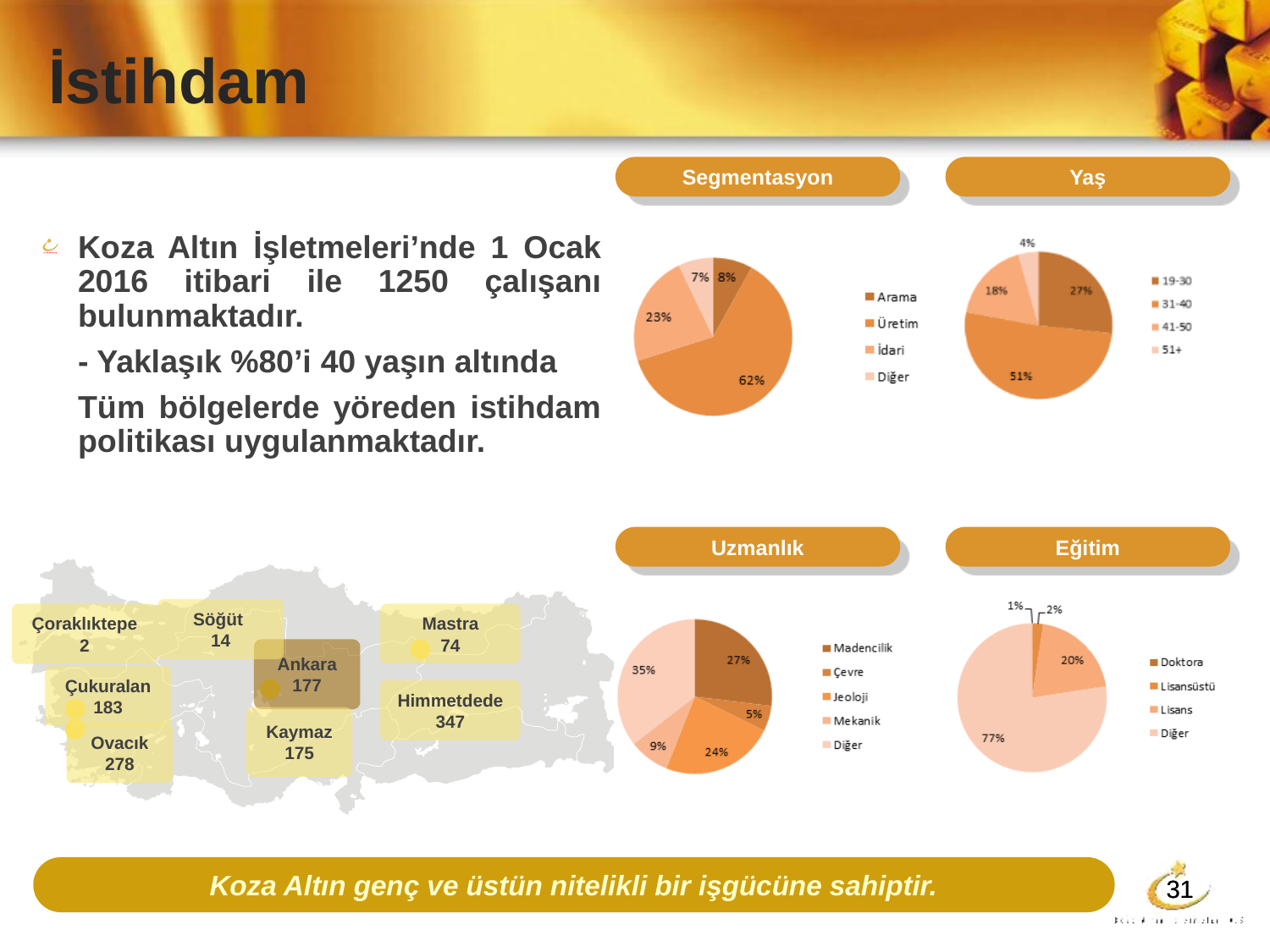
In the Yaş pie chart, which age group has the smallest share? 51+ In the Segmentasyon pie chart, what percentage is Üretim? 62% In the Uzmanlık pie chart, which category has the largest share? Diğer In the Segmentasyon pie chart, what is the difference between the İdari and Diğer shares? 16% In the Yaş pie chart, which is larger: 19-30 or 41-50? 19-30 In the Uzmanlık pie chart, what percentage is Jeoloji? 24% How many slices does the Uzmanlık pie chart have? 5 How many categories does the legend of the Yaş chart list? 4 In the Yaş pie chart, what percentage is the 31-40 age group? 51% What type of chart is used for Eğitim? Pie chart In the Segmentasyon pie chart, which category has the largest share? Üretim In the Eğitim pie chart, what percentage is Lisans? 20%